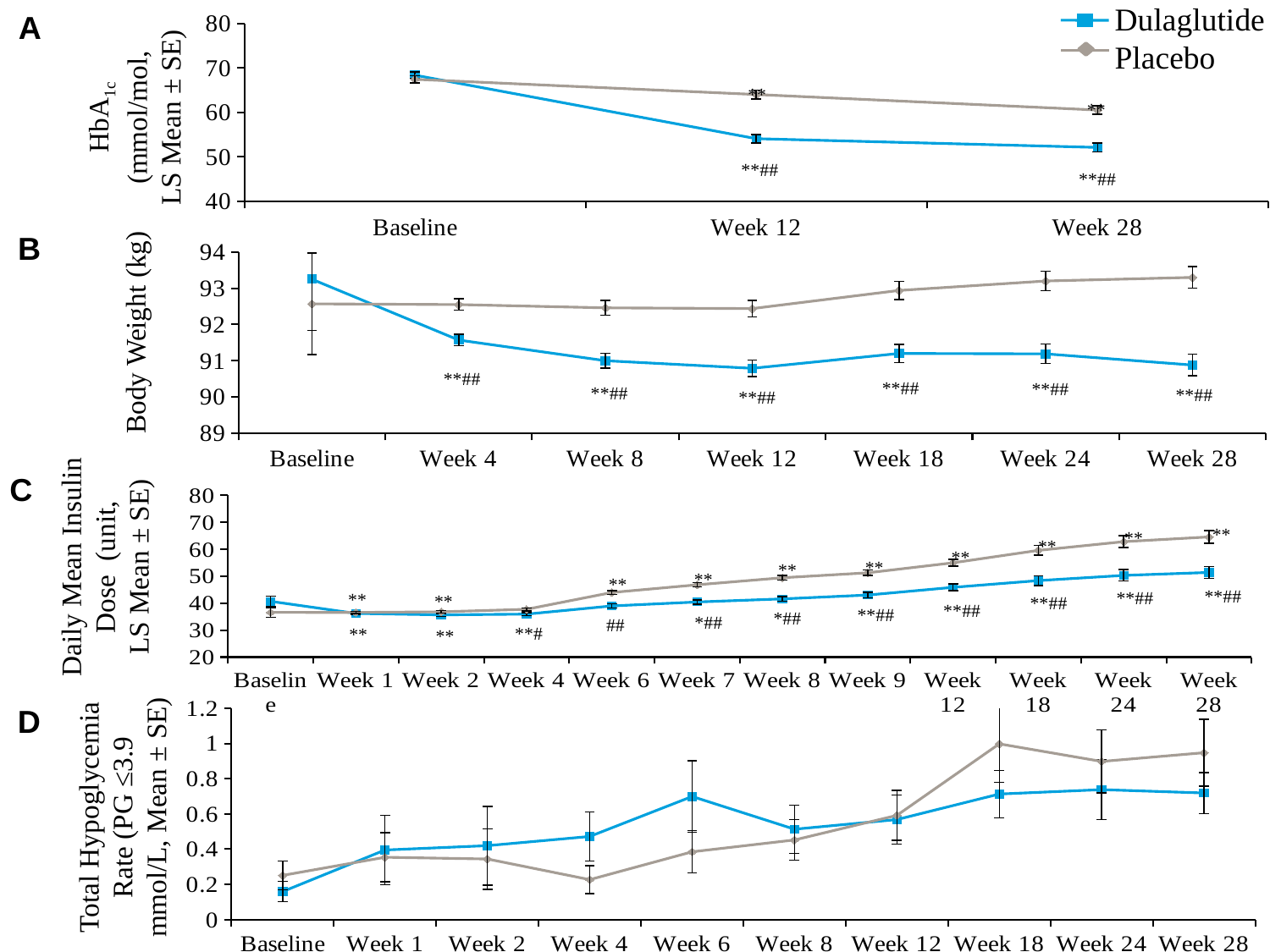
In chart D (Total Hypoglycemia Rate), at which time point is the Dulaglutide value lowest? Baseline In chart B (Body Weight), which series has the larger value at Week 28, Dulaglutide or Placebo? Placebo How many series does the legend list? 2 In chart C (Daily Mean Insulin Dose), how many time points are shown on the x axis? 12 In chart B (Body Weight), how many time points are shown on the x axis? 7 What kind of chart is chart A (HbA1c)? line chart In chart A (HbA1c), how many time points are shown on the x axis? 3 In chart A (HbA1c), is the Dulaglutide value at Week 28 greater or less than 60? less Which colour is used for the Dulaglutide series? blue In chart B (Body Weight), is the Placebo value at Week 28 greater or less than 93? greater In chart A (HbA1c), does the Dulaglutide line rise or fall from Baseline to Week 28? fall In chart C (Daily Mean Insulin Dose), is the Placebo value at Week 28 greater or less than 60? greater